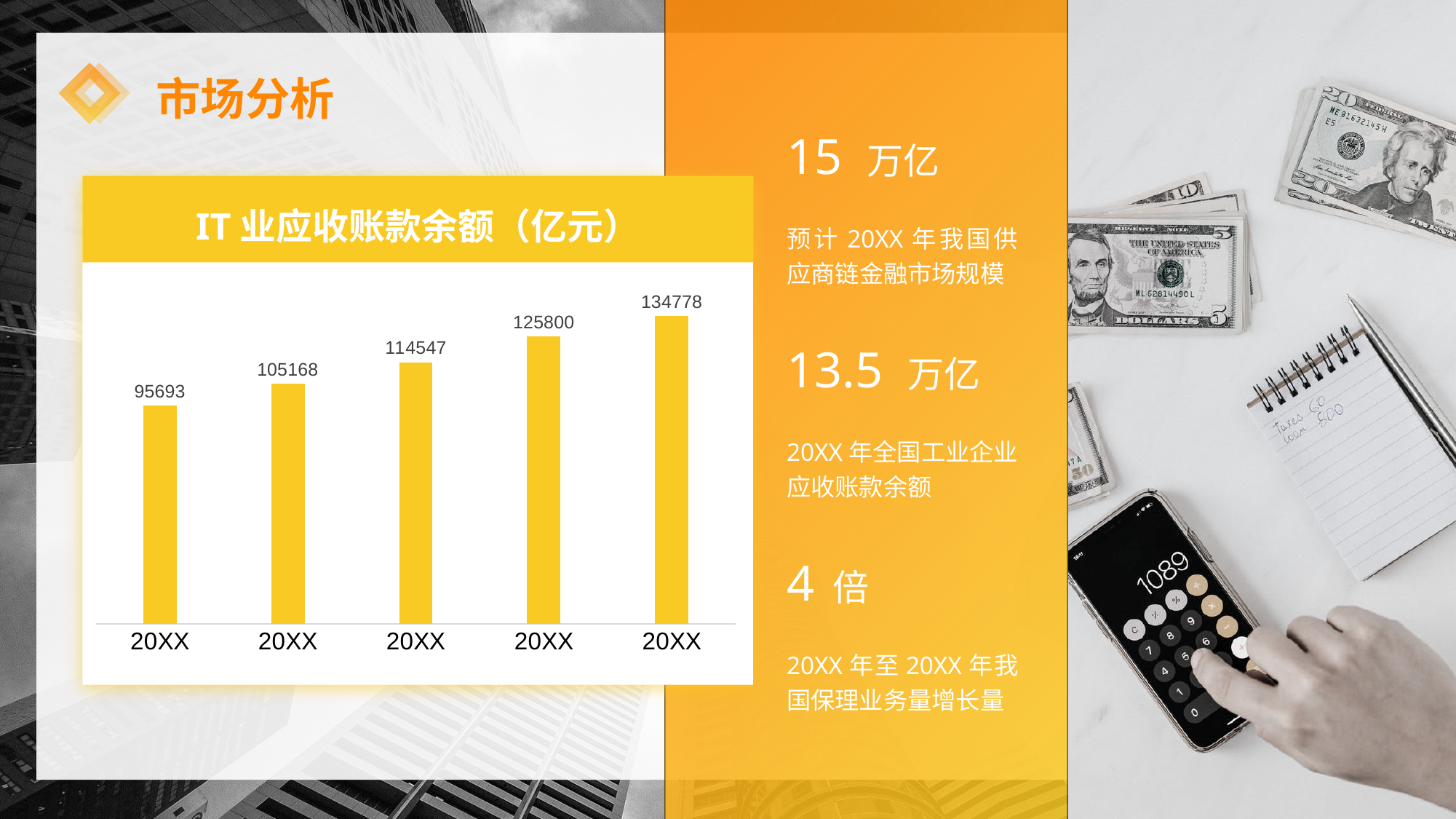
Which bar has the lowest value in the chart? the leftmost bar (95693) Which bar has the highest value in the chart? the rightmost bar (134778) What is the value of the middle (third) bar in the chart? 114547 How many bars are plotted in the chart? 5 What is the value of the fourth bar from the left in the chart? 125800 What is the difference between the rightmost bar and the leftmost bar in the chart? 39085 Which is larger, the second bar from the left or the third bar from the left? the third bar (114547) What is the value of the leftmost bar in the chart? 95693 What is the title of the chart? IT 业应收账款余额（亿元） What is the value of the rightmost bar in the chart? 134778 Do the values rise or fall from left to right along the x axis? rise What type of chart is shown on the slide? bar chart